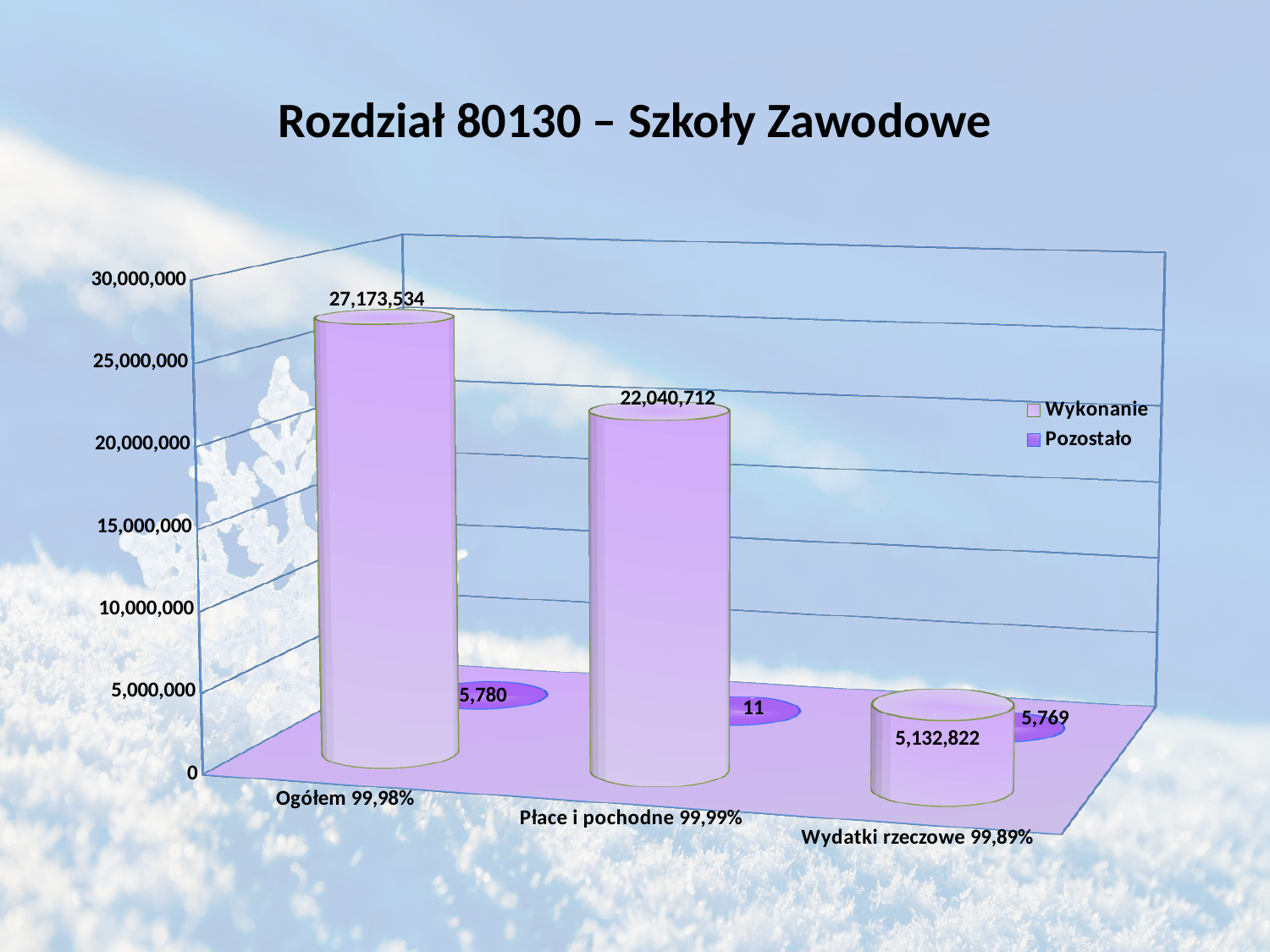
Which category has the lowest Pozostało value? Płace i pochodne 99,99% What is the Wykonanie value for Wydatki rzeczowe 99,89%? 5,132,822 What is the title of the chart? Rozdział 80130 – Szkoły Zawodowe What is the Pozostało value for Wydatki rzeczowe 99,89%? 5,769 What is the Pozostało value for Płace i pochodne 99,99%? 11 Which category has the highest Wykonanie value? Ogółem 99,98% What is the difference between the Wykonanie values for Ogółem 99,98% and Płace i pochodne 99,99%? 5,132,822 What is the Pozostało value for Ogółem 99,98%? 5,780 How many series does the legend list? 2 How many categories are shown on the x axis? 3 What is the Wykonanie value for Ogółem 99,98%? 27,173,534 What is the Wykonanie value for Płace i pochodne 99,99%? 22,040,712